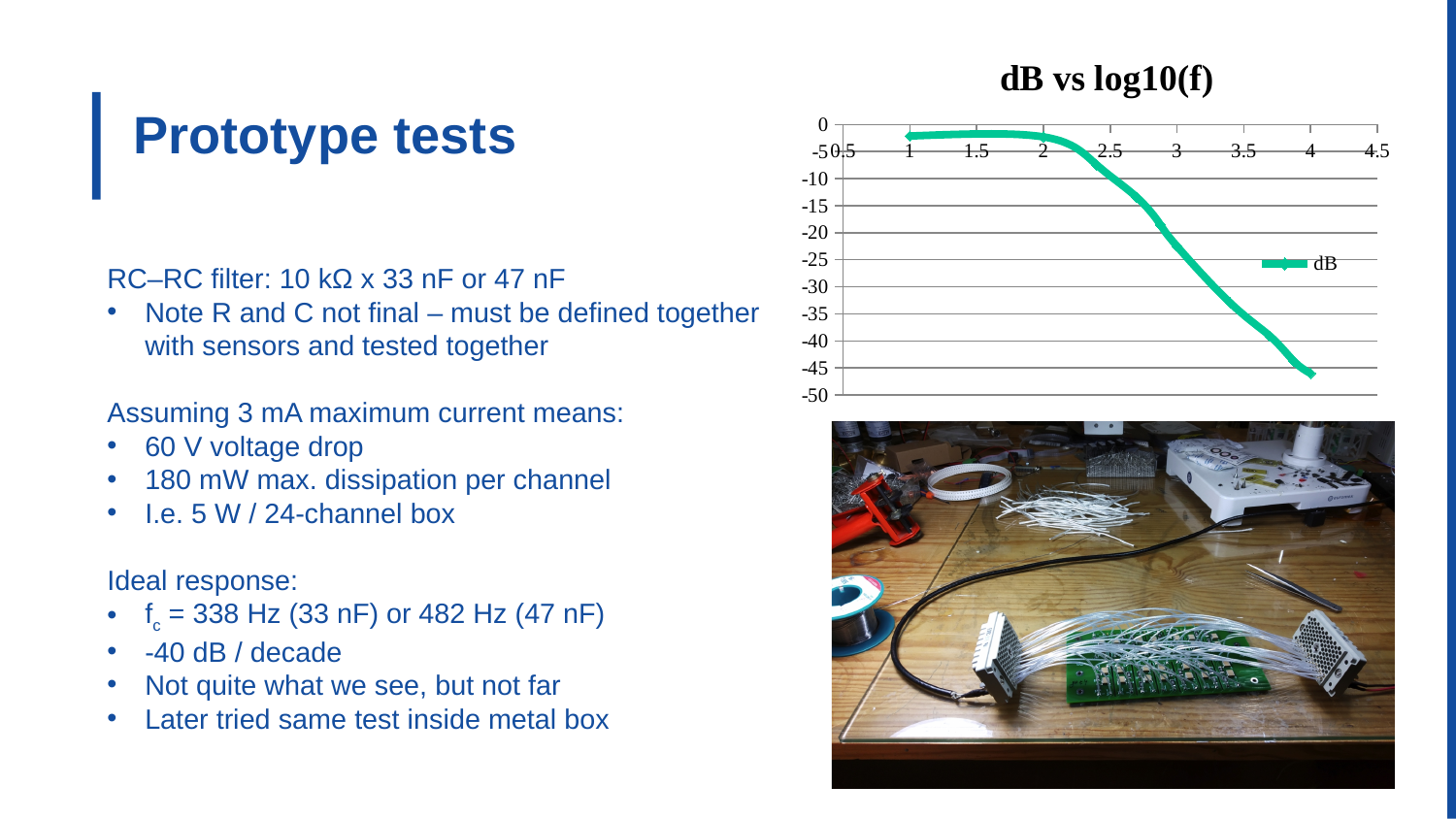
What is the lowest value shown on the vertical axis of the "dB vs log10(f)" chart? -50 In the "dB vs log10(f)" chart, do the dB values rise or fall as log10(f) increases from 2 to 4? fall In the "dB vs log10(f)" chart, is the dB value larger at log10(f) = 2 or at log10(f) = 3? log10(f) = 2 In the "dB vs log10(f)" chart, is the dB value at log10(f) = 2.5 greater or less than -20? greater What is the title of the chart on the slide? dB vs log10(f) What kind of chart is shown under the title "dB vs log10(f)"? line chart In the "dB vs log10(f)" chart, is the dB value at log10(f) = 3.5 greater or less than -30? less In the "dB vs log10(f)" chart, at which log10(f) value does the plotted line reach its lowest dB value? 4 In the "dB vs log10(f)" chart, is the dB value at log10(f) = 1 greater or less than -5? greater What is the name of the series shown in the legend of the "dB vs log10(f)" chart? dB How many series does the legend of the "dB vs log10(f)" chart list? 1